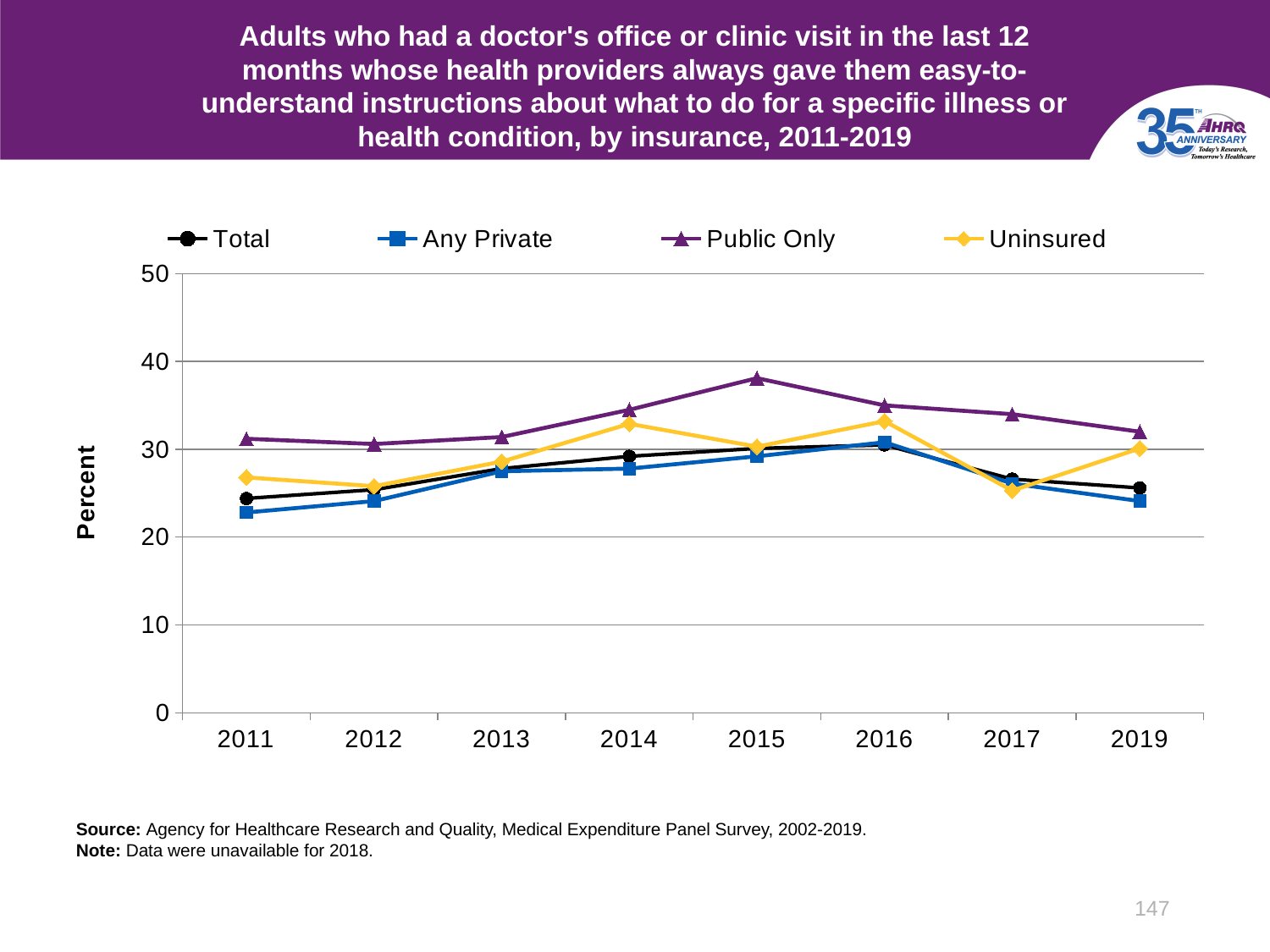
Does the Public Only series rise or fall from 2015 to 2019? Fall Is the value for Any Private in 2011 greater or less than 30? less How many series does the legend list? 4 How many years are plotted along the x axis? 8 What kind of chart is shown on the slide? Line chart According to the note, for which year were data unavailable? 2018 What is the label on the y axis? Percent Which series has the highest value in 2015? Public Only In 2019, which is larger: the value for Uninsured or the value for Any Private? Uninsured Is the value for Public Only in 2015 greater or less than 30? greater In which year does the Public Only series reach its highest value? 2015 Is the value for Public Only in 2015 greater or less than 40? less